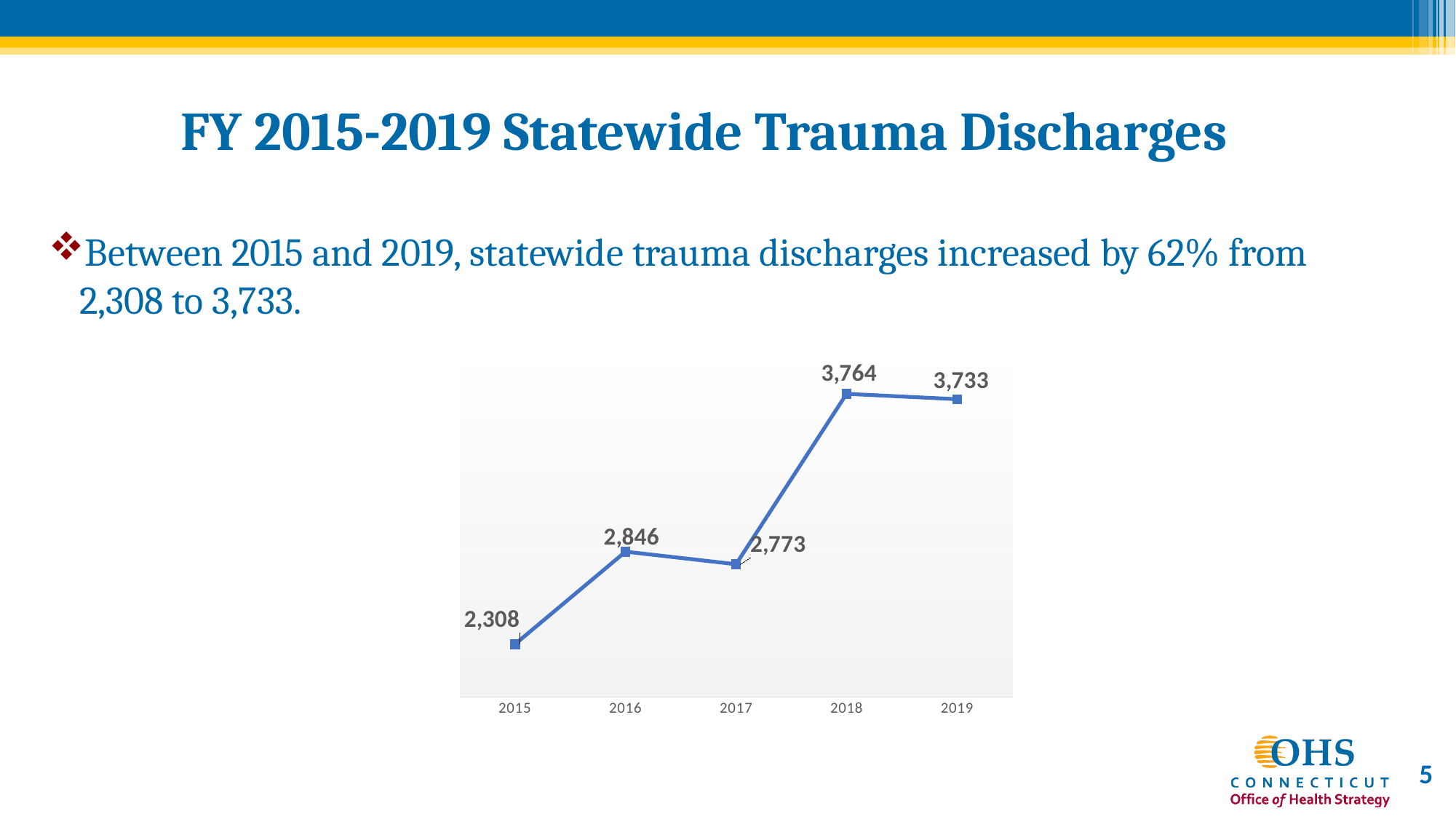
How many years are plotted on the chart? 5 Which year had more trauma discharges, 2016 or 2017? 2016 What was the number of statewide trauma discharges in 2015? 2,308 Which year had the lowest number of trauma discharges? 2015 What kind of chart is shown on the slide? Line chart What was the number of statewide trauma discharges in 2019? 3,733 Which year had the highest number of trauma discharges? 2018 What was the number of statewide trauma discharges in 2017? 2,773 Did trauma discharges rise or fall from 2017 to 2018? Rise What is the difference in trauma discharges between 2016 and 2015? 538 What is the title of the slide containing the chart? FY 2015-2019 Statewide Trauma Discharges What is the difference in trauma discharges between 2018 and 2017? 991